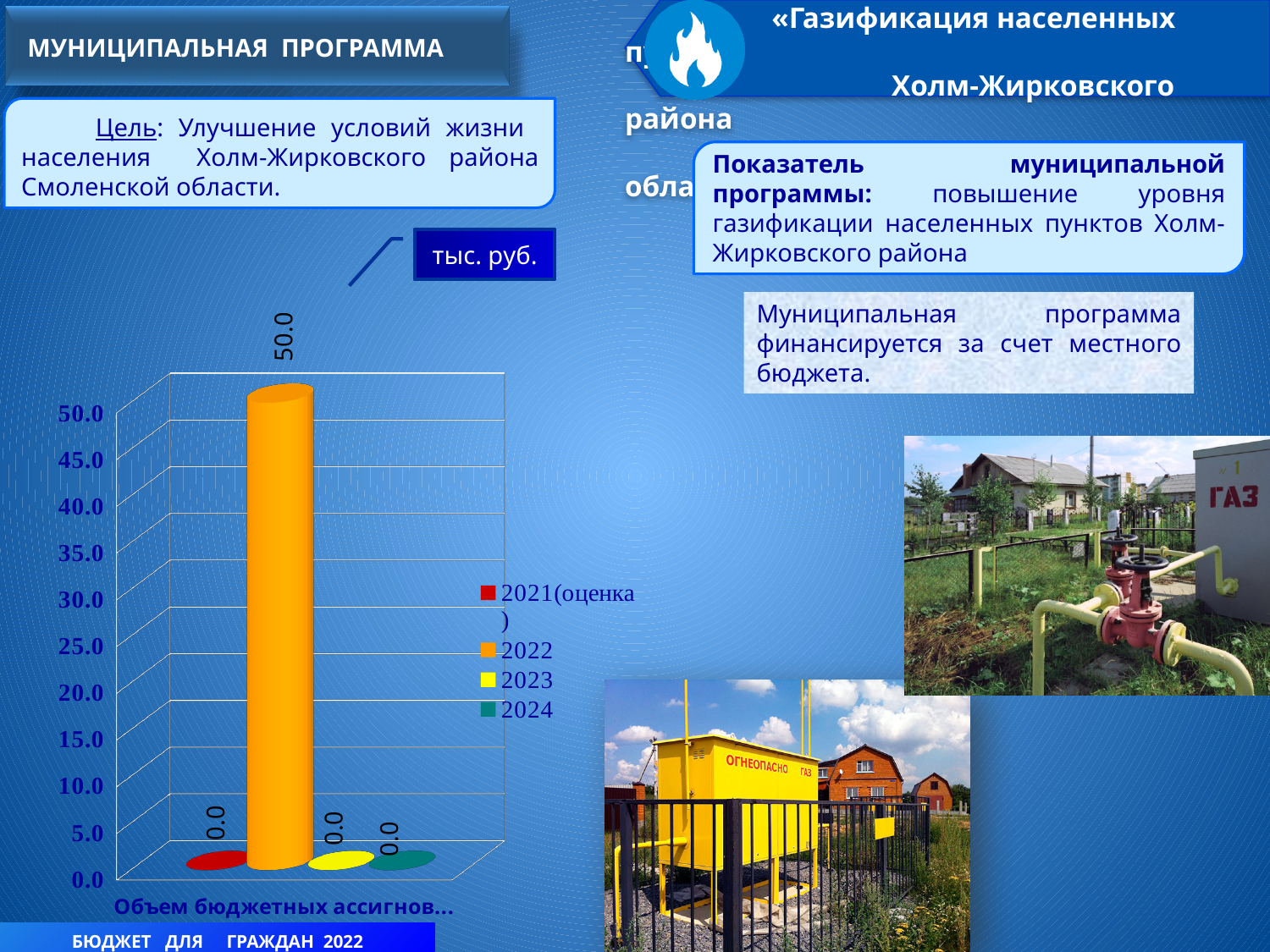
Which is larger, the value for 2022 or the value for 2024? 2022 What is the value for the 2023 series in the chart? 0.0 Is the value for 2022 greater or less than 45.0? greater What is the value for the 2024 series in the chart? 0.0 What colour is the bar for the 2022 series? orange What kind of chart is shown on the slide? bar chart What unit is indicated for the chart values? тыс. руб. What is the value for the 2022 series in the chart? 50.0 Which series has the highest value in the chart? 2022 What is the difference between the 2022 value and the 2023 value? 50.0 How many series does the legend list? 4 What is the value for the 2021(оценка) series in the chart? 0.0